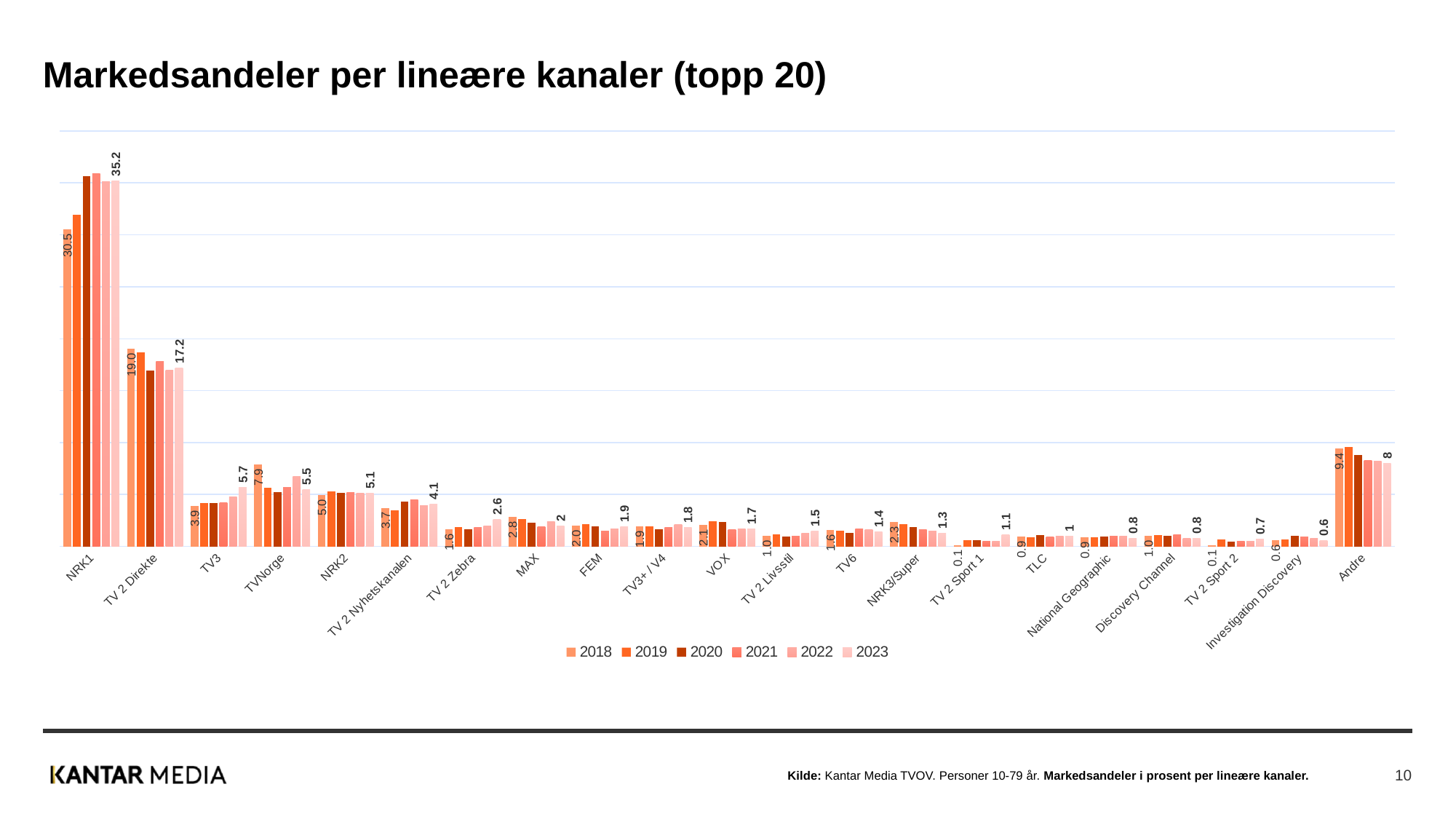
What is the title of the chart? Markedsandeler per lineære kanaler (topp 20) Which channel has the highest 2023 value? NRK1 What is the 2018 value for TV 2 Direkte? 19.0 What is the 2023 value for NRK1? 35.2 What kind of chart is shown on the slide? Bar chart What is the 2023 value for TVNorge? 5.5 What is the difference between the 2023 and 2018 values for NRK1? 4.7 How many series does the legend list? 6 Which is larger for TV3: the 2018 value or the 2023 value? 2023 What is the 2018 value for Andre? 9.4 How many categories are shown on the x axis? 21 What is the difference between the 2018 and 2023 values for TVNorge? 2.4